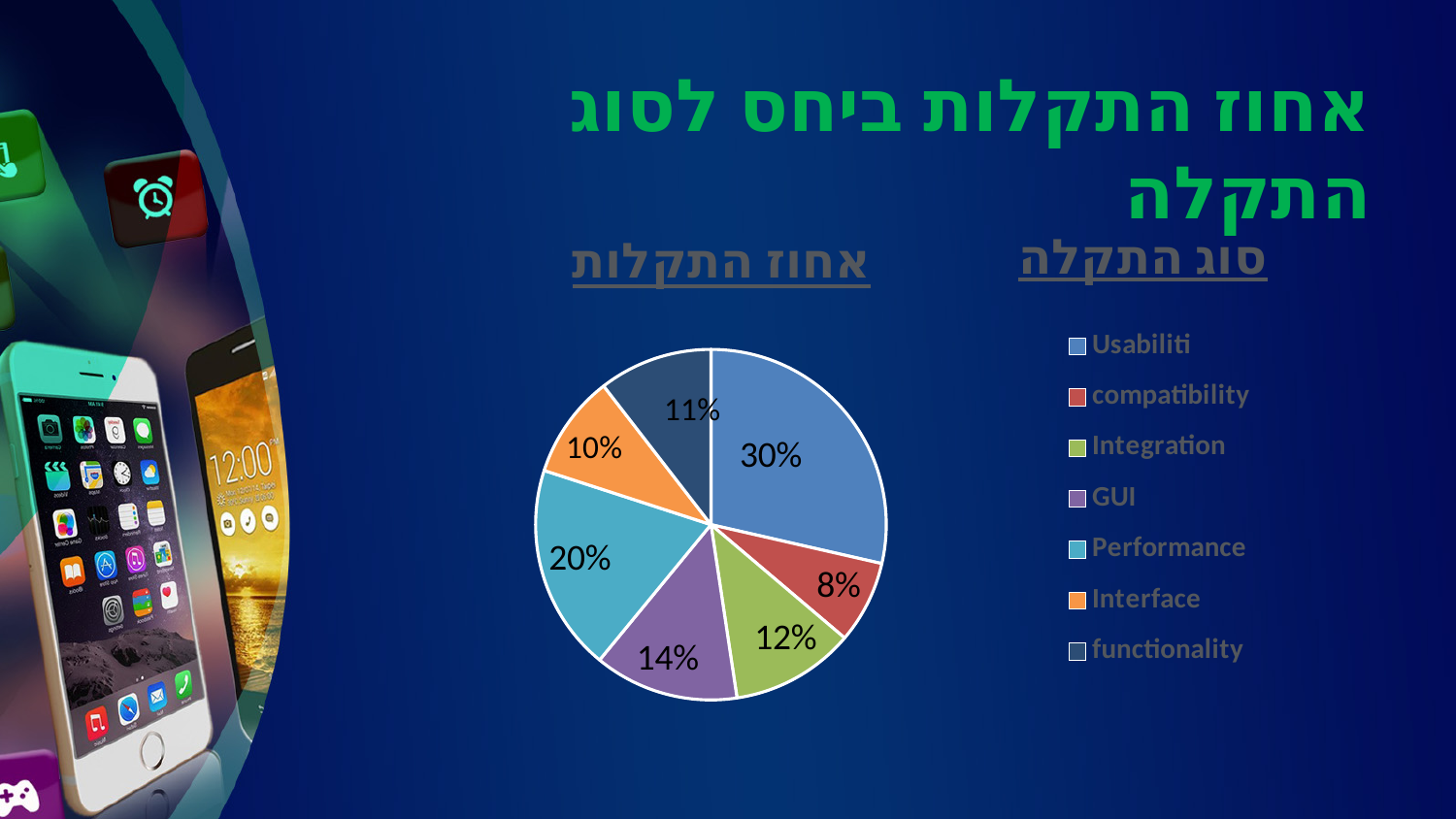
What kind of chart is shown on the slide? Pie chart Which category has the smallest slice of the pie chart? compatibility How many entries does the legend list? 7 What percentage of the pie chart is compatibility? 8% What colour is the functionality slice in the pie chart? Dark blue-gray How many slices does the pie chart have? 7 What percentage of the pie chart is GUI? 14% Which category has the largest slice of the pie chart? Usabiliti Which is larger, the Integration slice or the Interface slice? Integration What percentage of the pie chart is Performance? 20% What is the difference in percentage points between Usabiliti and Performance? 10 What percentage of the pie chart is Usabiliti? 30%